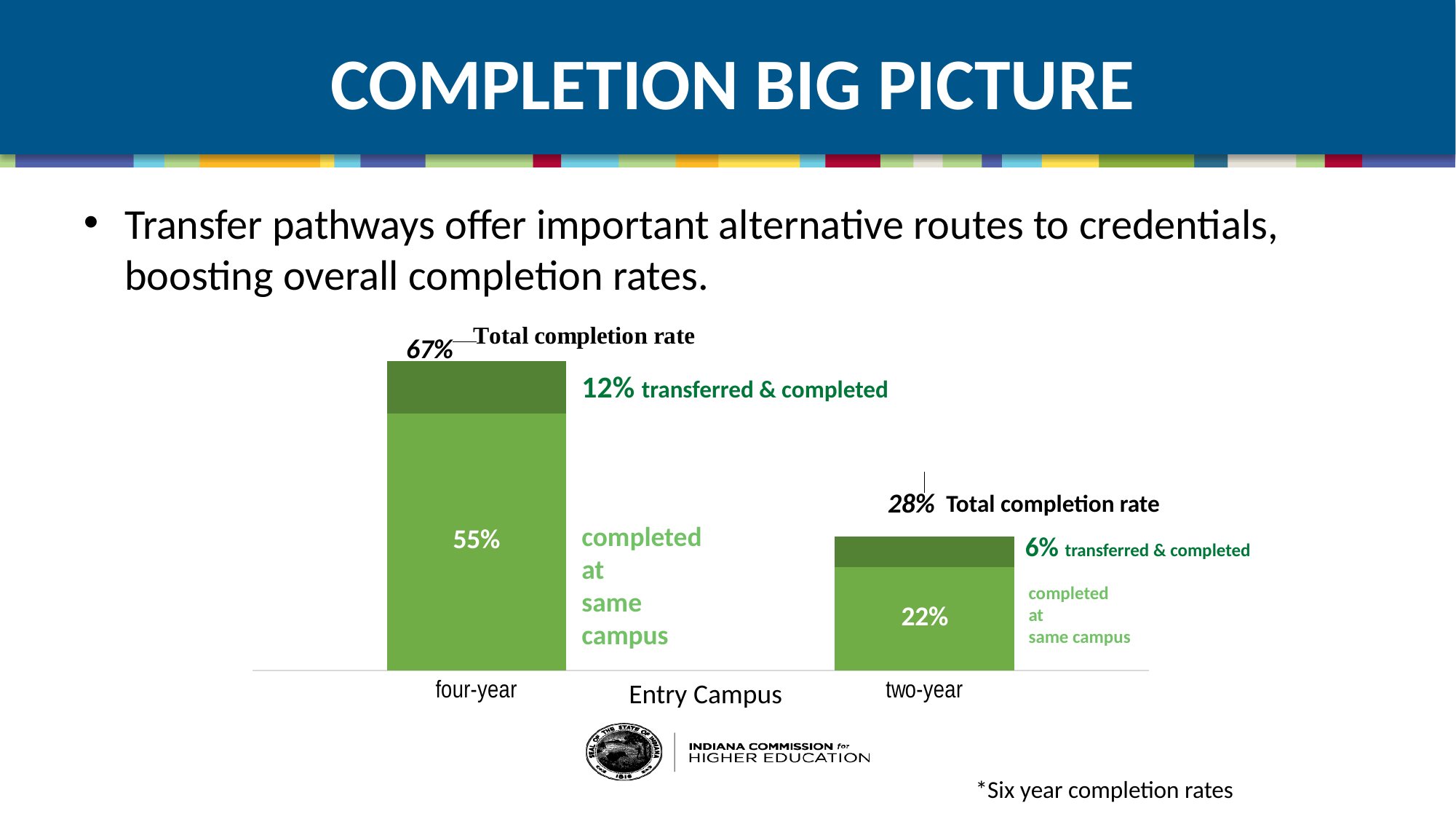
What type of chart is shown on the slide? Stacked bar chart Is the 'transferred & completed' rate larger for the four-year or the two-year entry campus? four-year What percentage of four-year entry students transferred and completed? 12% How many entry campus categories are shown on the chart? 2 Which entry campus has the higher total completion rate? four-year What is the difference between the total completion rates of the four-year and two-year entry campuses? 39% What is the total completion rate for the four-year entry campus? 67% What is the difference between the 'completed at same campus' rates for four-year and two-year entry campuses? 33% What percentage of four-year entry students completed at the same campus? 55% What percentage of two-year entry students completed at the same campus? 22% What percentage of two-year entry students transferred and completed? 6% What is the total completion rate for the two-year entry campus? 28%